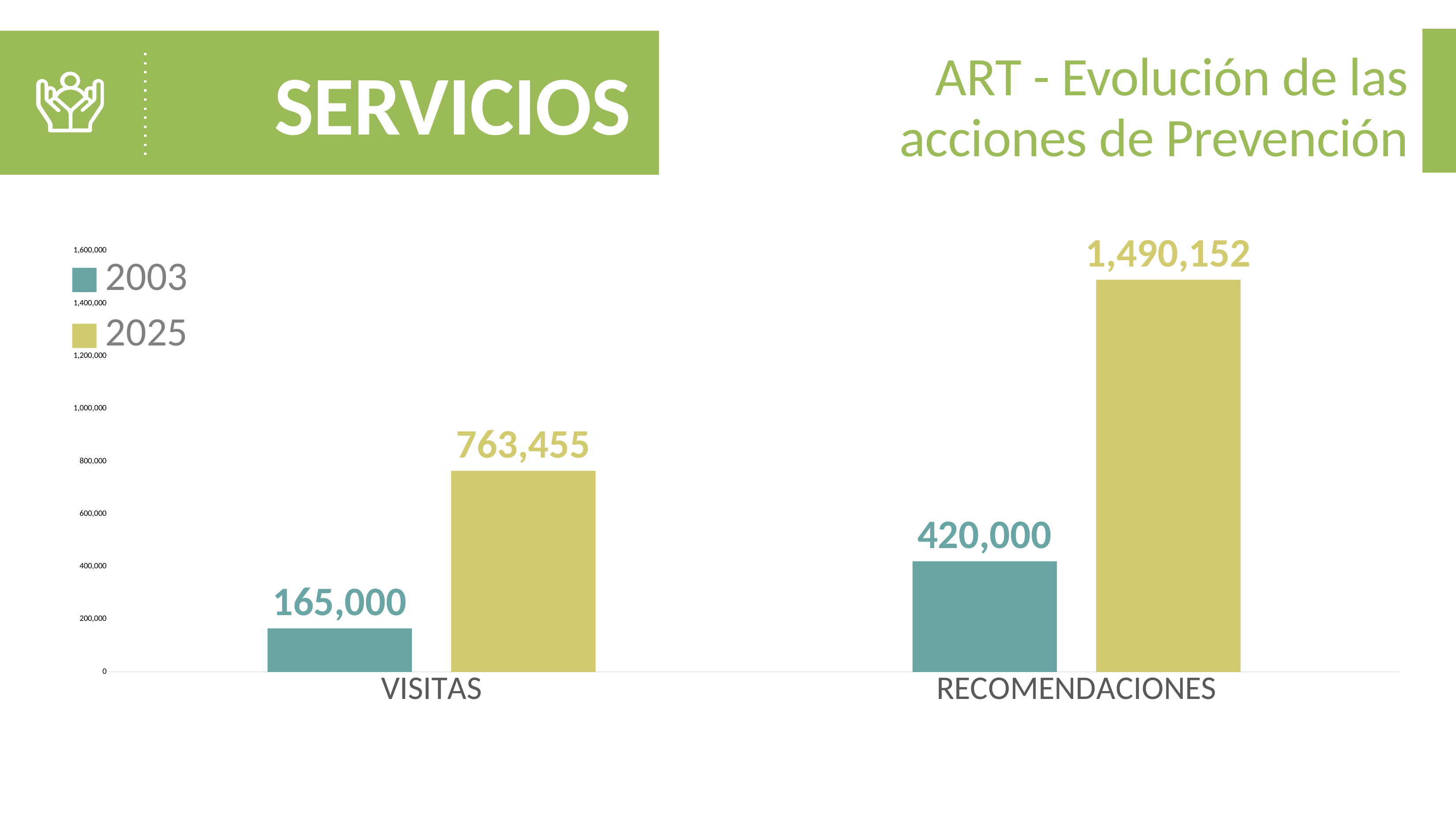
What is the value for RECOMENDACIONES in 2025? 1,490,152 Which category has the highest value in 2025? RECOMENDACIONES What is the value for RECOMENDACIONES in 2003? 420,000 What is the difference between the 2025 and 2003 values for VISITAS? 598,455 How many series does the legend list? 2 What kind of chart is shown on the slide? Bar chart Which category has the lowest value in 2003? VISITAS What is the difference between the 2025 and 2003 values for RECOMENDACIONES? 1,070,152 Which is larger: VISITAS in 2025 or RECOMENDACIONES in 2003? VISITAS in 2025 What is the value for VISITAS in 2025? 763,455 What is the value for VISITAS in 2003? 165,000 How many categories are shown on the x axis? 2